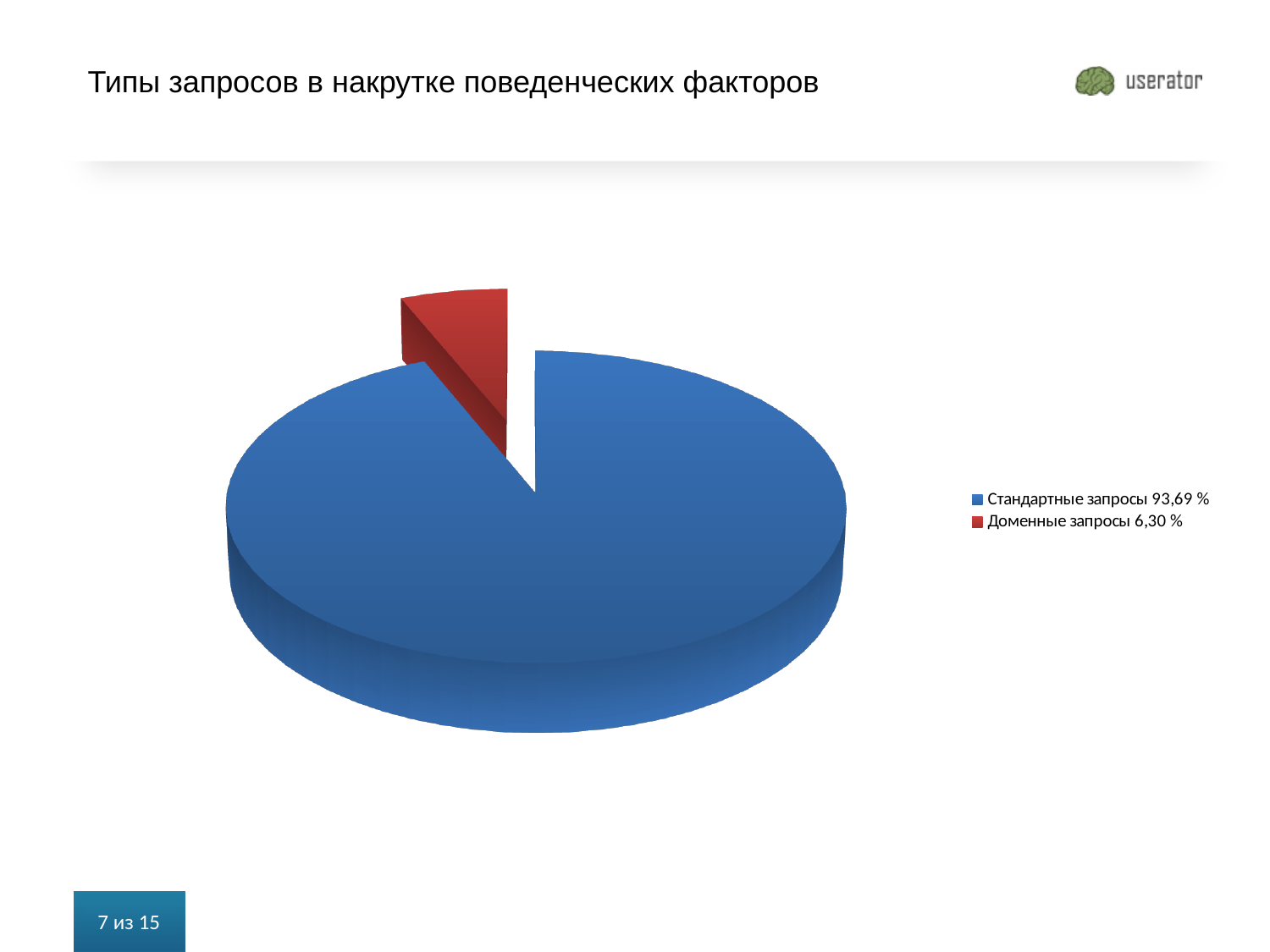
Which is larger: Стандартные запросы or Доменные запросы? Стандартные запросы What share of the pie is Доменные запросы? 6,30 % Which category has the largest share of the pie? Стандартные запросы What is the difference in percentage points between Стандартные запросы and Доменные запросы? 87,39 What share of the pie is Стандартные запросы? 93,69 % How many slices does the pie chart have? 2 What kind of chart is shown on the slide? pie chart What colour is the slice for Доменные запросы? red How many entries does the legend list? 2 What is the title of the slide containing the chart? Типы запросов в накрутке поведенческих факторов Which category has the smallest share of the pie? Доменные запросы